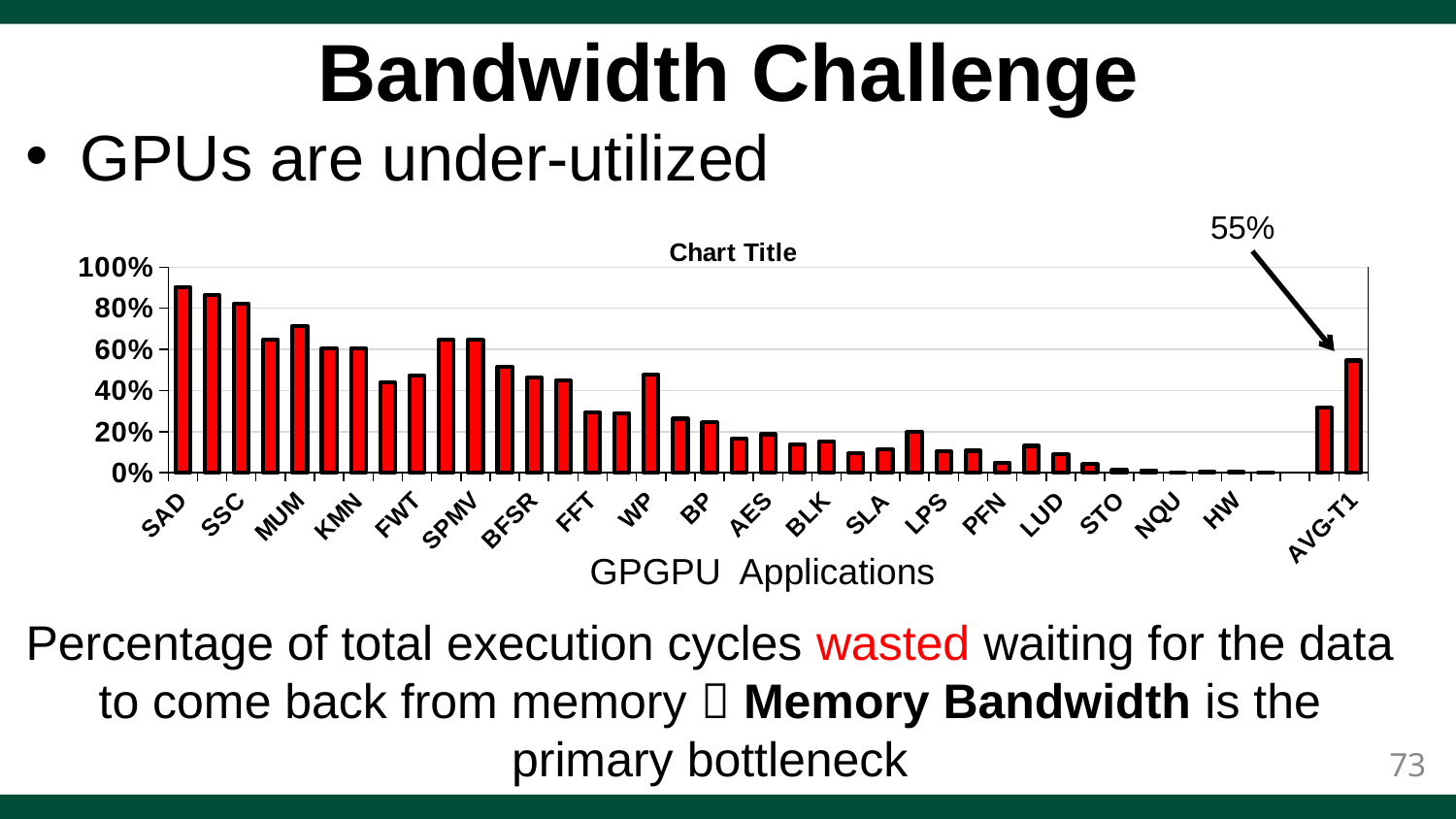
Is the value for FWT greater or less than 60%? less Is the value for SAD greater or less than 80%? greater Which has the larger value, SAD or STO? SAD Is the value for STO greater or less than 20%? less What is the label on the x axis of the chart? GPGPU Applications Which has the larger value, AVG-T1 or HW? AVG-T1 What kind of chart is shown on the slide? bar chart Which has the larger value, FWT or SPMV? SPMV Do the bar values generally rise or fall moving from SAD to HW along the x axis? fall What is the title shown above the chart? Chart Title What value is annotated for the AVG-T1 bar? 55%